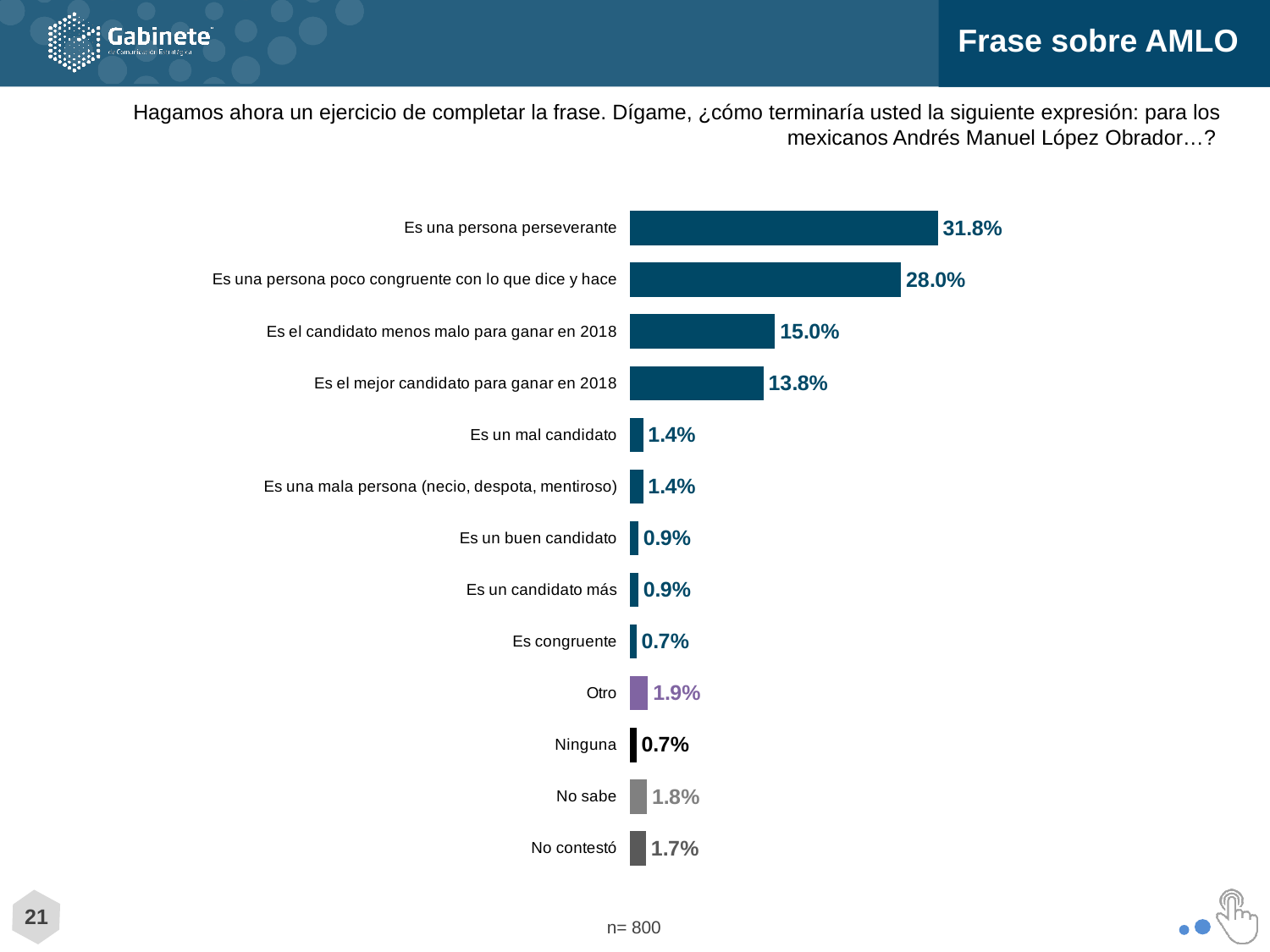
What sample size (n) is indicated at the bottom of the slide? n= 800 What is the difference between "Es el candidato menos malo para ganar en 2018" and "Es el mejor candidato para ganar en 2018"? 1.2 percentage points What type of chart is shown on the slide? Bar chart Which response has the highest percentage? Es una persona perseverante What percentage of respondents said "Es una persona perseverante"? 31.8% What is the value for "Otro"? 1.9% What percentage is shown for "No sabe"? 1.8% What is the value shown for "Es el mejor candidato para ganar en 2018"? 13.8% What is the difference between "Es una persona perseverante" and "Es una persona poco congruente con lo que dice y hace"? 3.8 percentage points Which is larger: "Es un mal candidato" or "Es un buen candidato"? Es un mal candidato How many response categories are shown in the chart? 13 Which is larger: "No sabe" or "No contestó"? No sabe